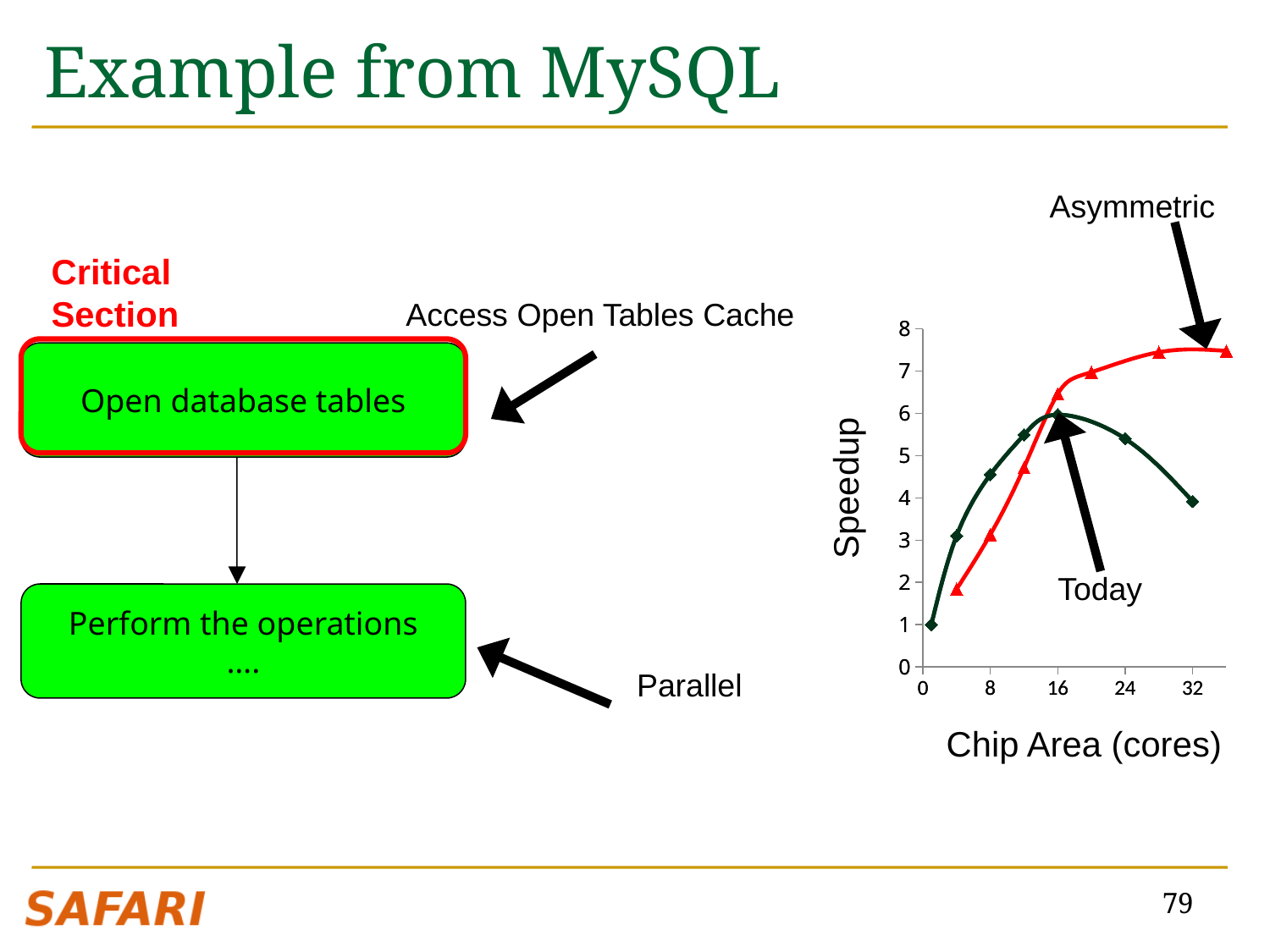
What kind of chart is shown on the right of the slide? line chart Is the speedup of the Today curve at 32 cores greater or less than 5? less What is the label of the x axis of the chart? Chip Area (cores) At 32 cores, which curve has the higher speedup, Asymmetric or Today? Asymmetric Does the Asymmetric curve rise or fall as chip area increases from 0 to 32 cores? rise What is the label of the y axis of the chart? Speedup Does the Today curve rise or fall as chip area increases from 16 to 32 cores? fall Is the speedup of the Today curve at 8 cores greater or less than 4? greater Is the speedup of the Asymmetric curve at 32 cores greater or less than 7? greater How many curves are plotted on the chart? 2